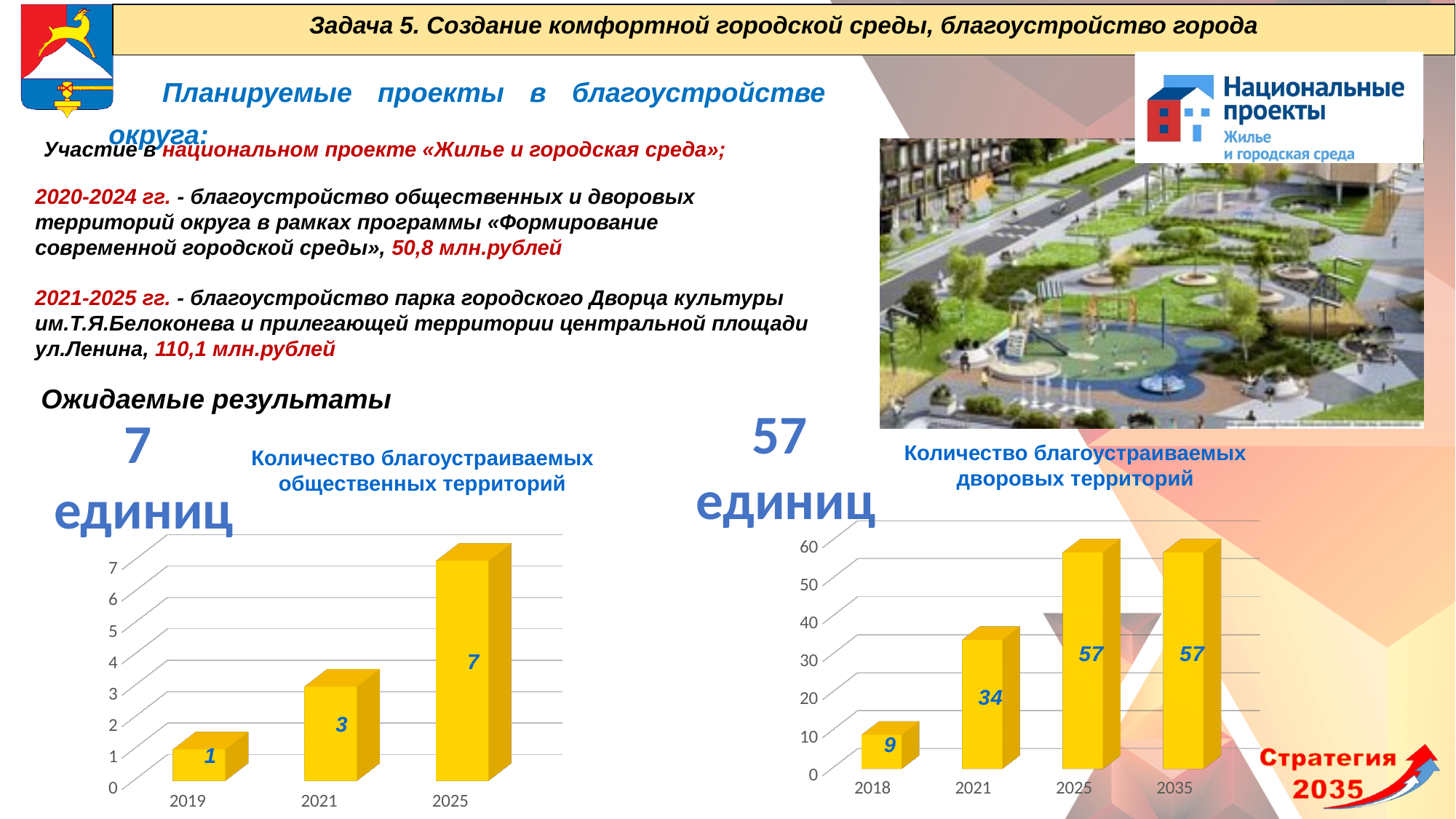
In the chart 'Количество благоустраиваемых общественных территорий', what is the difference between the values for 2025 and 2019? 6 In the chart 'Количество благоустраиваемых дворовых территорий', which year has the lowest value? 2018 In the chart 'Количество благоустраиваемых дворовых территорий', what is the value for 2021? 34 In the chart 'Количество благоустраиваемых общественных территорий', how many years are shown on the x axis? 3 In the chart 'Количество благоустраиваемых дворовых территорий', which is larger, the value for 2021 or the value for 2018? 2021 In the chart 'Количество благоустраиваемых общественных территорий', what is the value for 2021? 3 In the chart 'Количество благоустраиваемых общественных территорий', which year has the highest value? 2025 In the chart 'Количество благоустраиваемых дворовых территорий', how many years are shown on the x axis? 4 In the chart 'Количество благоустраиваемых дворовых территорий', what is the value for 2018? 9 In the chart 'Количество благоустраиваемых дворовых территорий', what is the difference between the values for 2025 and 2021? 23 In the chart 'Количество благоустраиваемых общественных территорий', do the values rise or fall from 2019 to 2025? rise What type of chart is 'Количество благоустраиваемых дворовых территорий'? bar chart